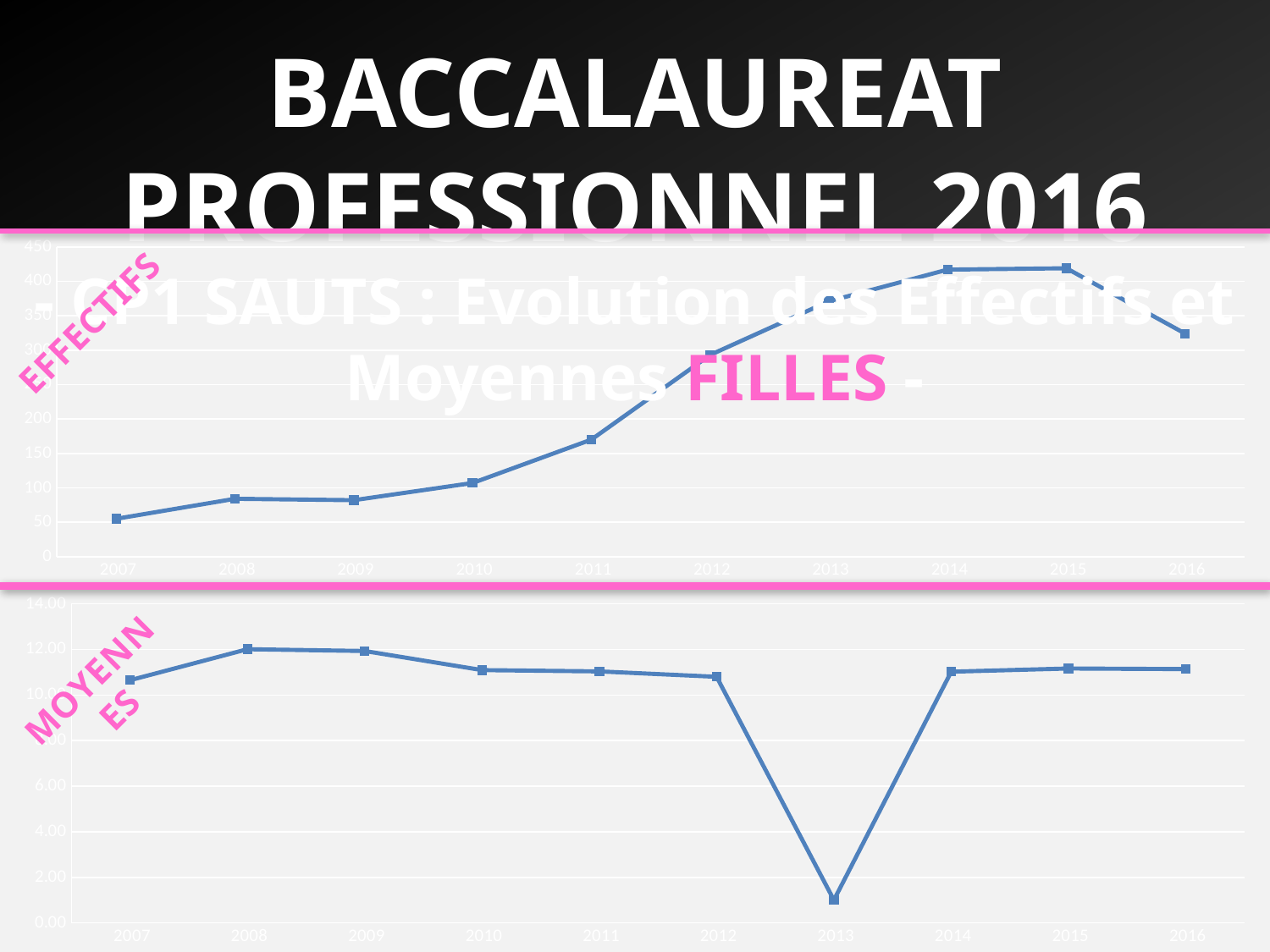
In the top chart (EFFECTIFS), is the value for 2014 greater or less than 400? greater In the bottom chart (MOYENNES), how many data points are plotted? 10 What kind of chart is the top chart labelled EFFECTIFS? line chart In the top chart (EFFECTIFS), which year has the lowest value? 2007 What is the pink label written along the left side of the bottom chart? MOYENNES In the top chart (EFFECTIFS), how many years are plotted along the x axis? 10 In the bottom chart (MOYENNES), which year has the lowest value? 2013 In the top chart (EFFECTIFS), which year has the larger value, 2012 or 2016? 2016 What kind of chart is the bottom chart labelled MOYENNES? line chart In the top chart (EFFECTIFS), do the values rise or fall from 2015 to 2016? fall In the bottom chart (MOYENNES), is the value for 2013 greater or less than 2.00? less In the top chart (EFFECTIFS), is the value for 2011 greater or less than 200? less